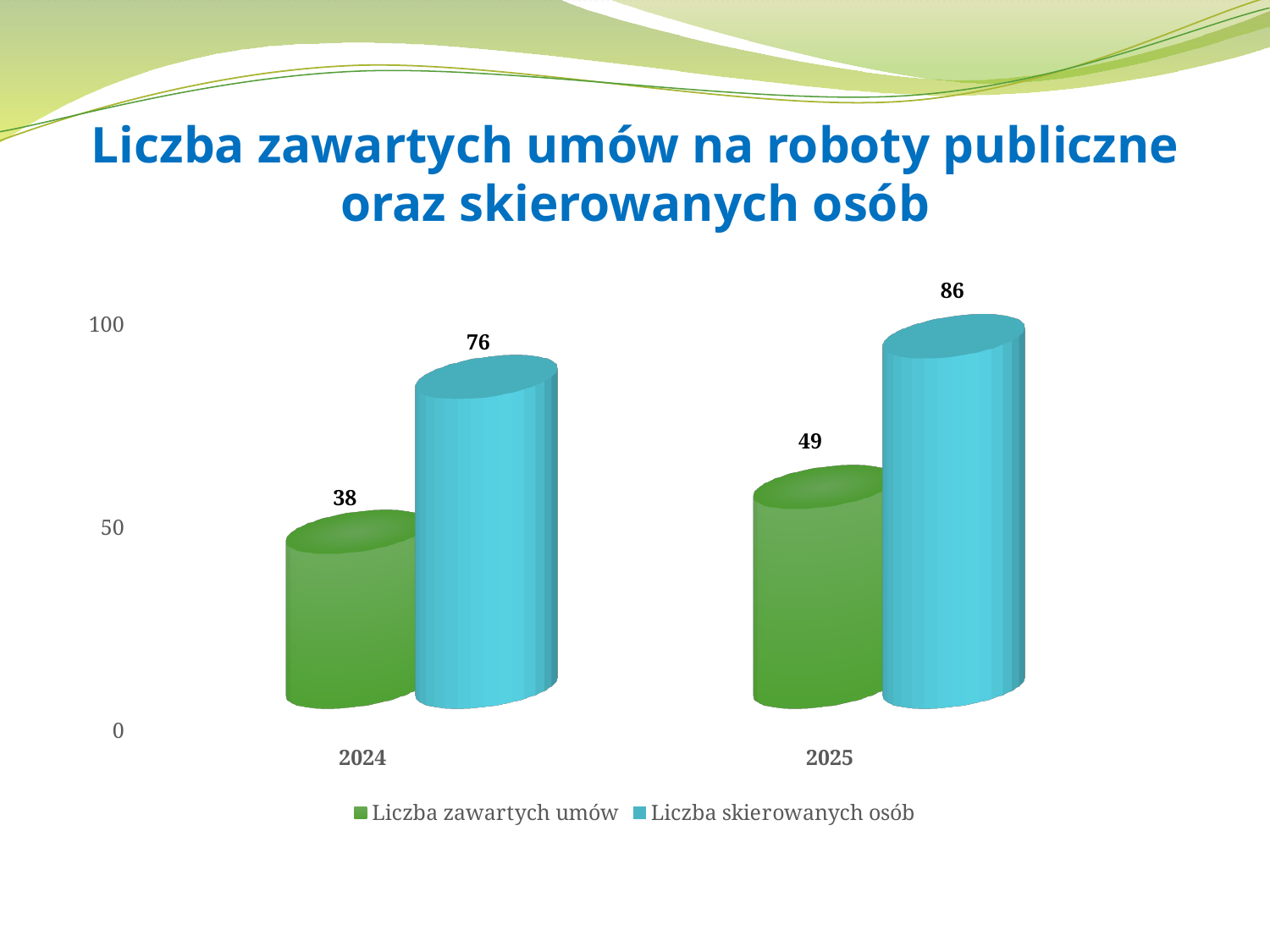
How many series does the legend list? 2 What is the difference between Liczba skierowanych osób in 2025 and in 2024? 10 What is the value of Liczba skierowanych osób for 2025? 86 What kind of chart is shown on the slide? Bar chart Which is larger in 2025: Liczba zawartych umów or Liczba skierowanych osób? Liczba skierowanych osób What is the value of Liczba zawartych umów for 2024? 38 Does Liczba zawartych umów rise or fall from 2024 to 2025? Rise What is the value of Liczba skierowanych osób for 2024? 76 Which year has the highest value for Liczba skierowanych osób? 2025 Which year has the lowest value for Liczba zawartych umów? 2024 What is the difference between Liczba skierowanych osób and Liczba zawartych umów in 2024? 38 What is the value of Liczba zawartych umów for 2025? 49